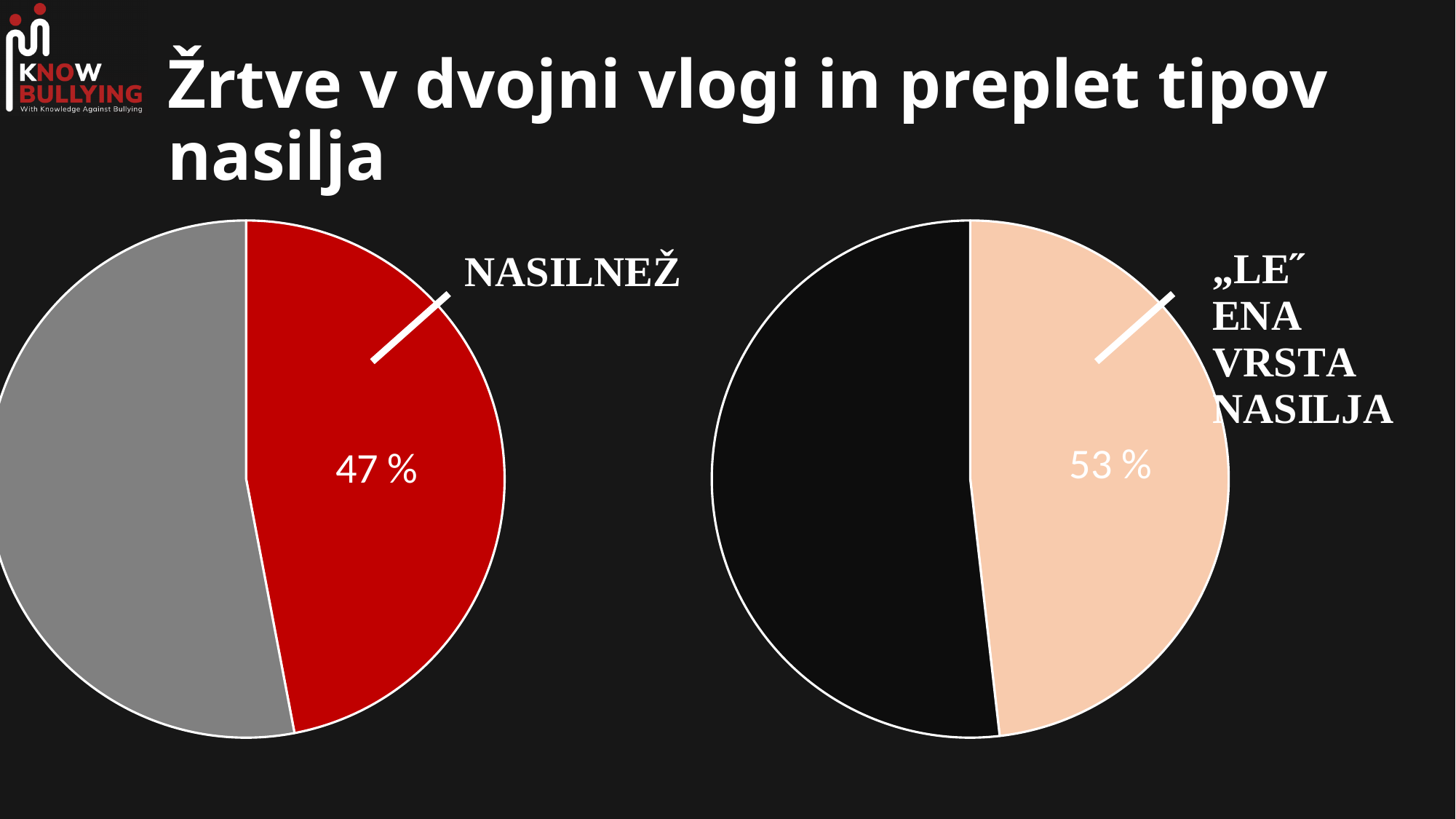
How many slices does the left pie chart have? 2 On the left pie chart, what colour is the slice labelled NASILNEŽ? Red On the left pie chart, which slice is larger, the red NASILNEŽ slice or the grey slice? The grey slice What kind of chart is the left chart on the slide? Pie chart On the left pie chart, is the NASILNEŽ slice greater or less than 50 %? less What kind of chart is the right chart on the slide? Pie chart On the left pie chart, what percentage is shown for the NASILNEŽ slice? 47 % How many slices does the right pie chart have? 2 On the right pie chart, what percentage is shown for the „LE" ENA VRSTA NASILJA slice? 53 % What is the title of the slide containing the two pie charts? Žrtve v dvojni vlogi in preplet tipov nasilja